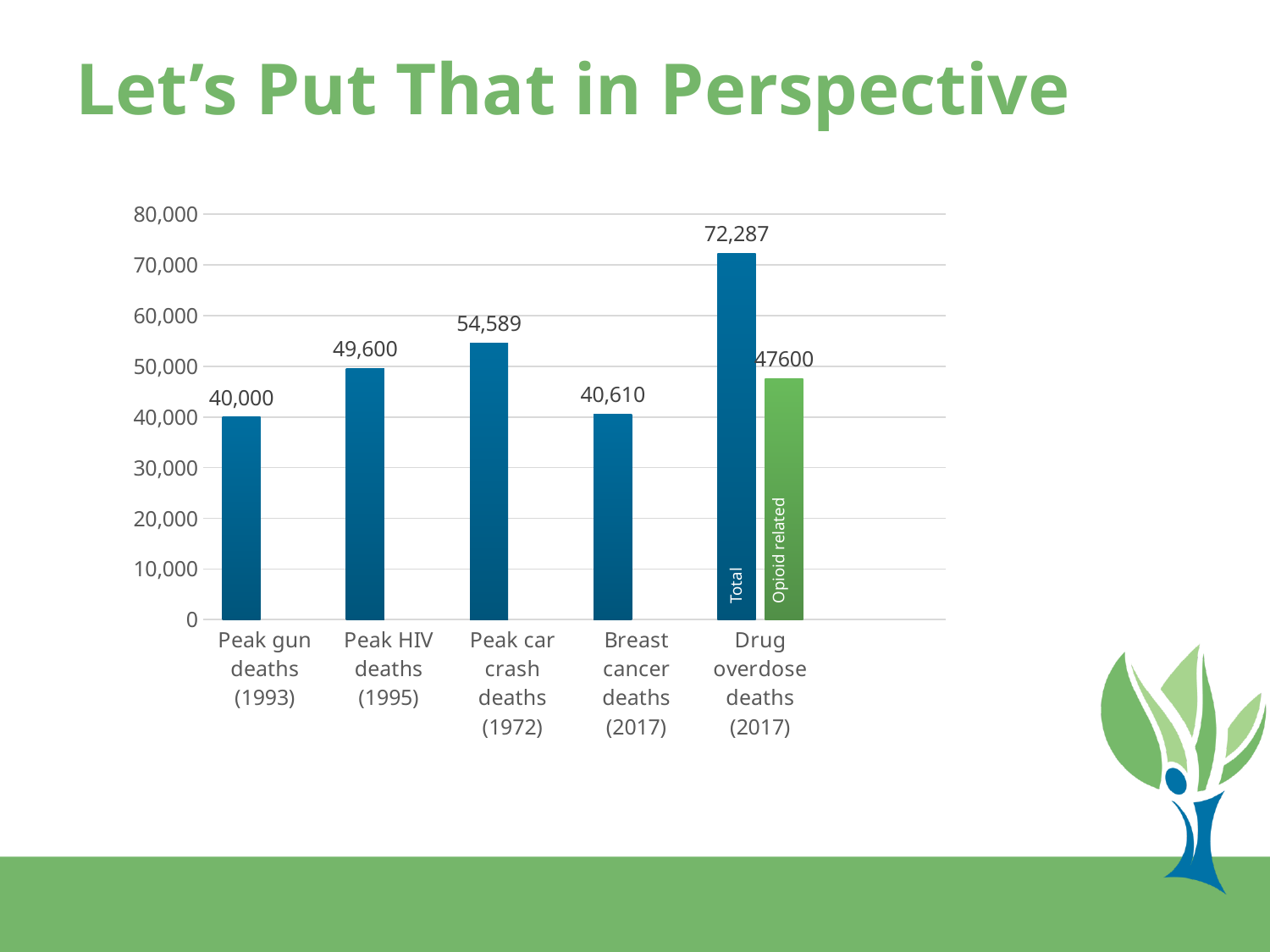
Which is larger, Peak HIV deaths (1995) or Breast cancer deaths (2017)? Peak HIV deaths (1995) Which category has the lowest value? Peak gun deaths (1993) What is the value for Breast cancer deaths (2017)? 40,610 What is the Total value for Drug overdose deaths (2017)? 72,287 What kind of chart is shown on the slide? Bar chart How many categories are shown on the x axis? 5 What is the value for Peak HIV deaths (1995)? 49,600 What is the value for Peak car crash deaths (1972)? 54,589 What is the value for Peak gun deaths (1993)? 40,000 Which category has the highest value? Drug overdose deaths (2017) What is the difference between Peak car crash deaths (1972) and Peak HIV deaths (1995)? 4,989 What is the Opioid related value for Drug overdose deaths (2017)? 47600